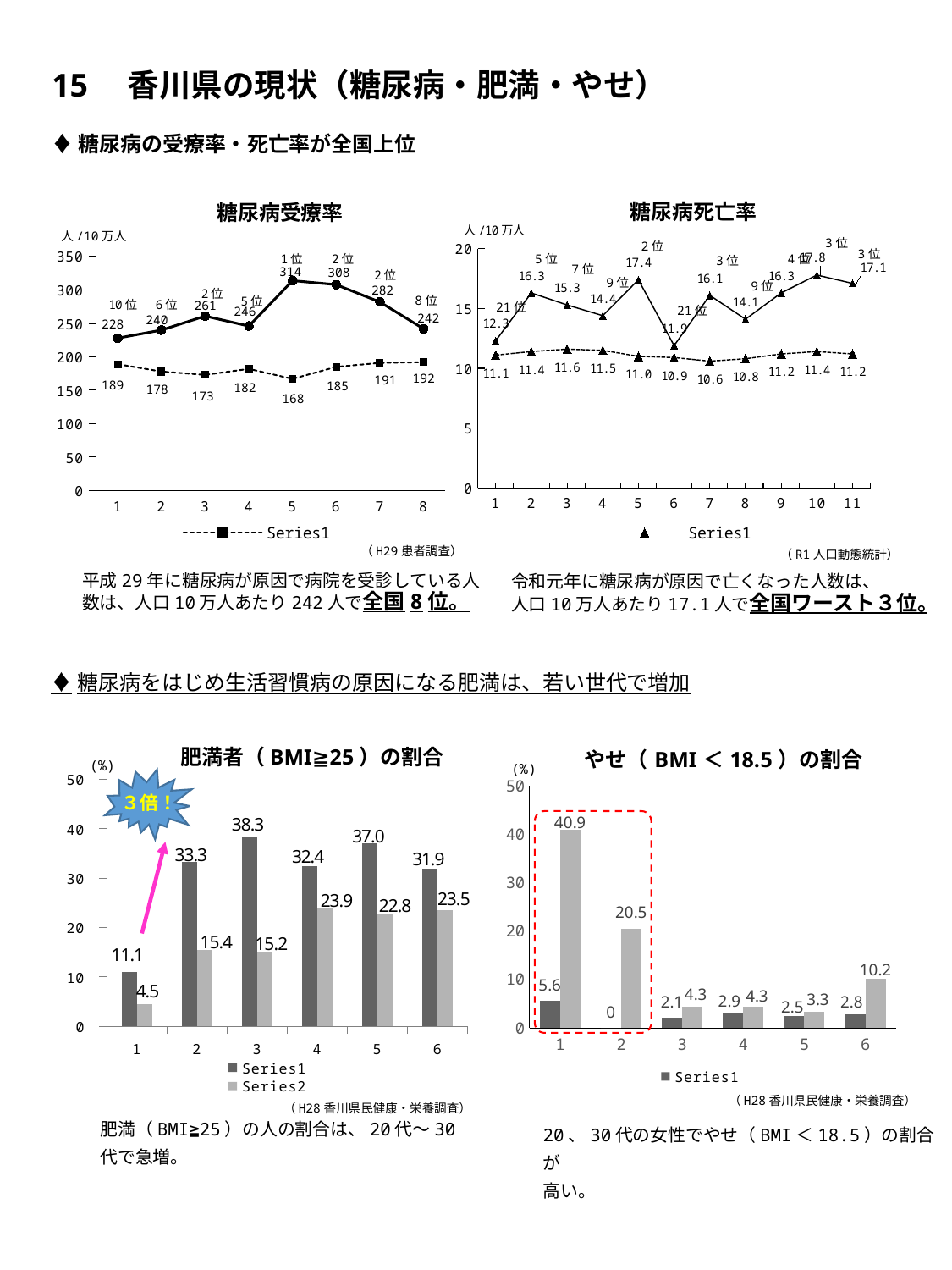
In the 肥満者（BMI≧25）の割合 chart, which is larger for category 4: Series1 or Series2? Series1 What type of chart is the 糖尿病死亡率 chart? line chart In the 糖尿病受療率 chart, at which category does the solid line reach its highest value? 5 In the 糖尿病受療率 chart, what is the value of the dashed Series1 line at category 8? 192 In the 糖尿病死亡率 chart, how many categories are on the x axis? 11 In the やせ（BMI＜18.5）の割合 chart, what is the value of the light grey bar for category 1? 40.9 In the 肥満者（BMI≧25）の割合 chart, how many series does the legend list? 2 In the 糖尿病死亡率 chart, what is the value of the solid line at category 11? 17.1 In the 肥満者（BMI≧25）の割合 chart, what is the Series1 value for category 3? 38.3 In the 糖尿病死亡率 chart, at which category is the dashed Series1 line lowest? 7 In the 糖尿病受療率 chart, what is the value of the solid line at category 5? 314 In the 糖尿病受療率 chart, what is the difference between the solid line and the dashed line at category 1? 39